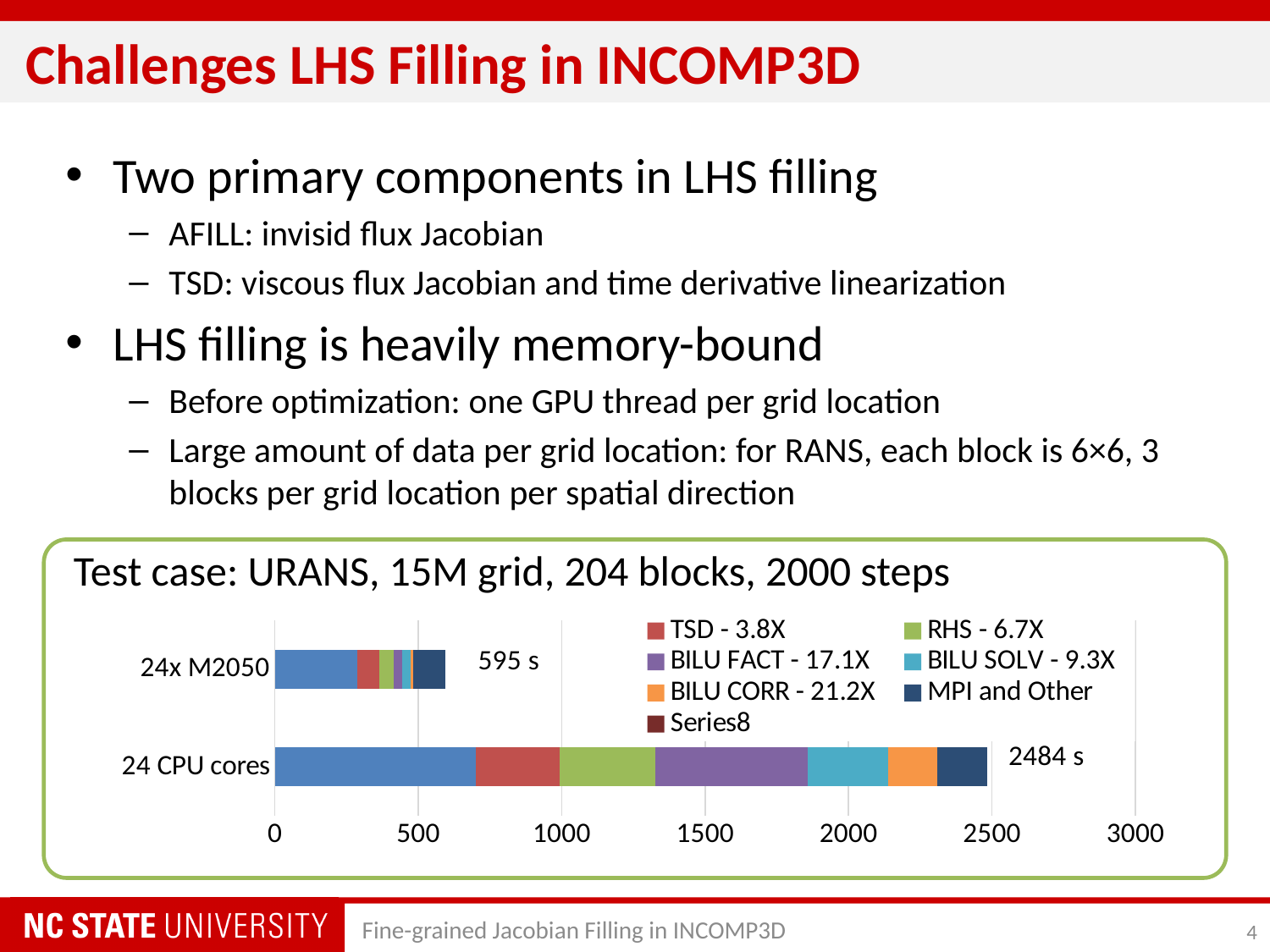
How many categories (bars) does the chart show? 2 What is the difference between the total time for 24 CPU cores and the total time for 24x M2050? 1889 s What speedup factor is shown in the legend entry for BILU CORR? 21.2X Is the total for 24x M2050 greater or less than 1000? less Is the first (blue) segment of the 24 CPU cores bar greater or less than 500? greater What is the total time labeled for the 24 CPU cores bar? 2484 s What is the total time labeled for the 24x M2050 bar? 595 s Which category has the lowest total time? 24x M2050 How many entries does the chart legend list? 7 Which bar has the larger total time, 24 CPU cores or 24x M2050? 24 CPU cores Is the total for 24 CPU cores greater or less than 2000? greater What kind of chart is shown on the slide? Stacked bar chart